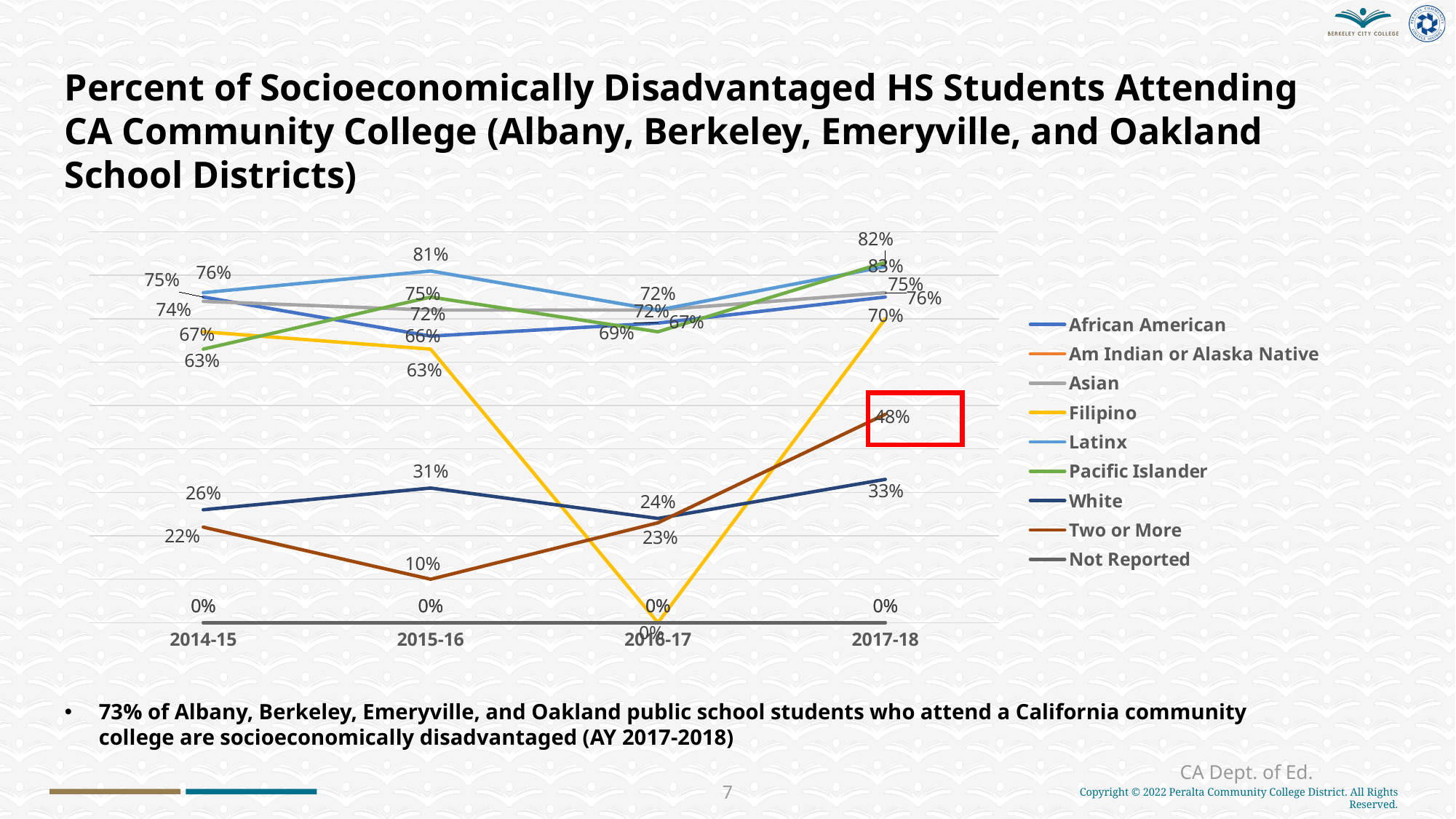
How many academic years are shown on the x axis? 4 Does the Two or More line rise or fall from 2015-16 to 2017-18? Rises What is the value for Two or More in 2015-16? 10% What is the value for Filipino in 2016-17? 0% By how many percentage points did the White value change from 2014-15 (26%) to 2017-18 (33%)? 7 percentage points What is the difference between the Two or More values in 2017-18 and 2016-17? 25 percentage points How many series does the legend list? 9 What is the value for Filipino in 2017-18? 70% What is the value for Two or More in 2017-18? 48% In 2017-18, which is larger: the White value or the Two or More value? Two or More What is the value for White in 2015-16? 31% What kind of chart is shown on the slide? Line chart